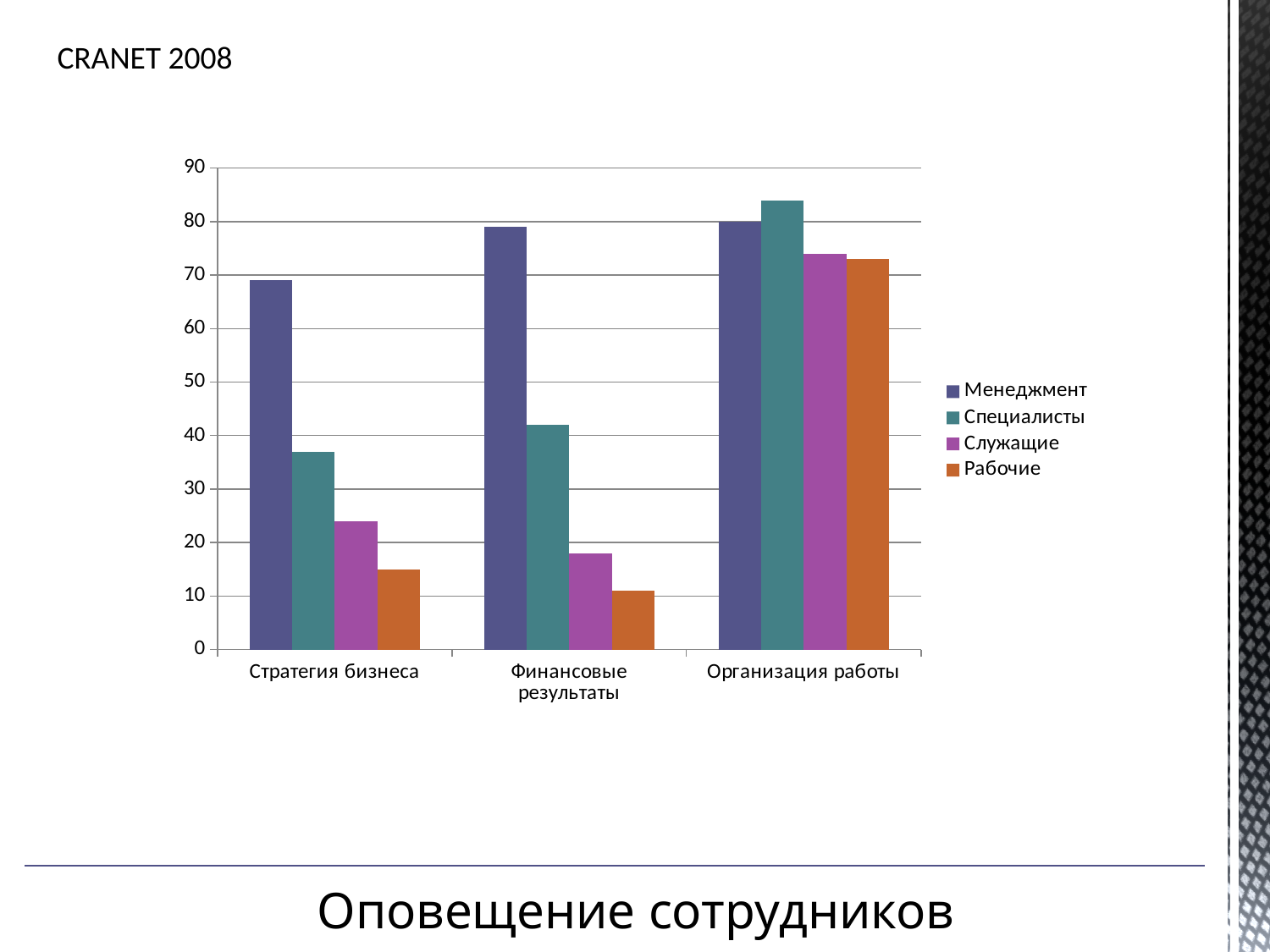
How many categories are shown on the x axis? 3 Is the value for Специалисты in Финансовые результаты greater or less than 50? less Which series has the highest value for Стратегия бизнеса? Менеджмент In which category does the Рабочие series reach its highest value? Организация работы Is the value for Служащие in Стратегия бизнеса greater or less than 30? less What is the label of the last entry in the legend? Рабочие Is the value for Рабочие in Организация работы greater or less than 60? greater Which is larger: Менеджмент in Финансовые результаты or Менеджмент in Стратегия бизнеса? Менеджмент in Финансовые результаты What kind of chart is shown on the slide? bar chart How many series does the legend list? 4 Which series has the lowest value for Финансовые результаты? Рабочие